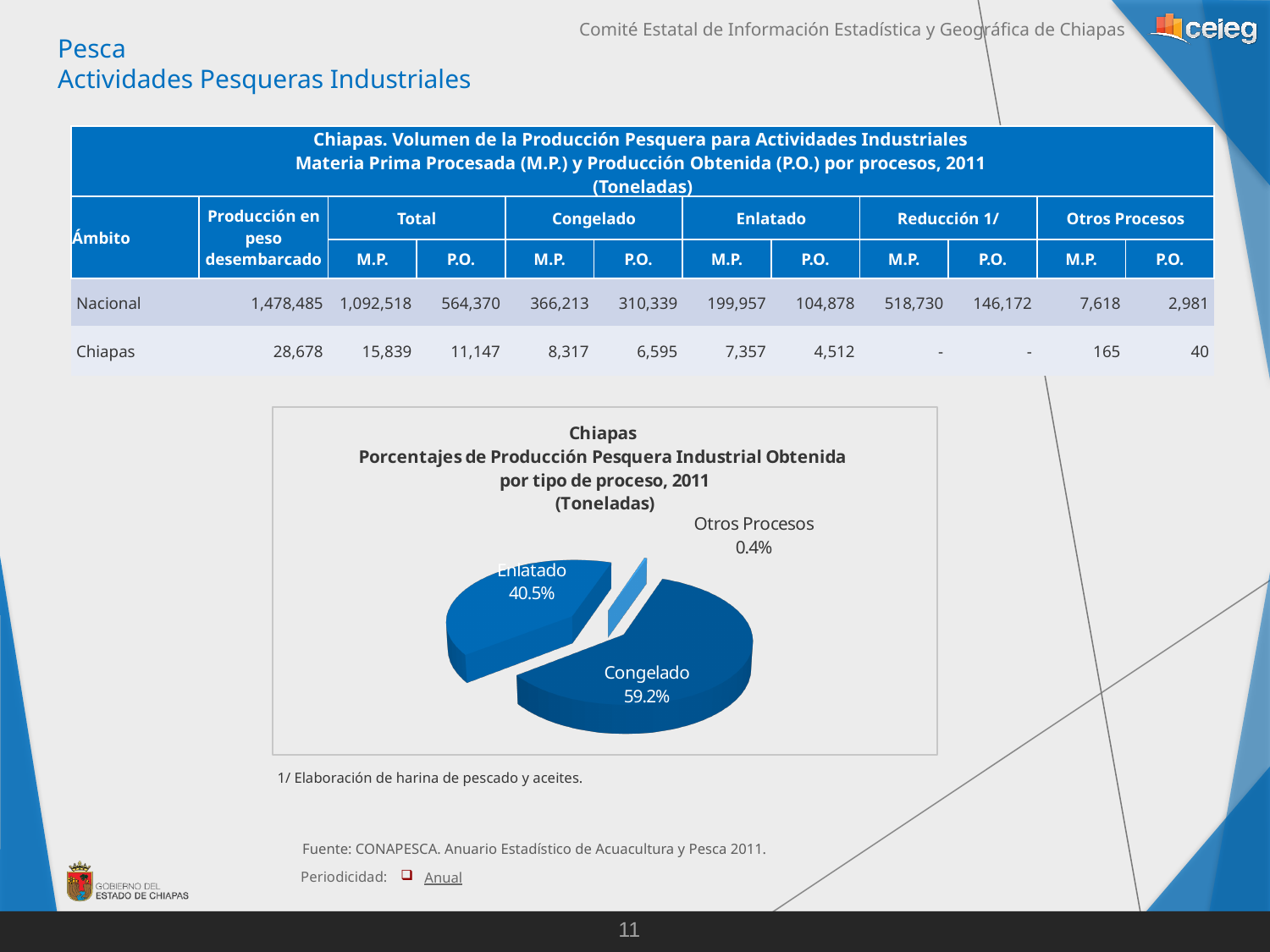
Which slice is larger, Enlatado or Otros Procesos? Enlatado What share of the pie does Otros Procesos represent? 0.4% How many slices does the pie chart have? 3 What kind of chart is shown on the slide? Pie chart What year does the pie chart title refer to? 2011 Which process type has the largest slice of the pie? Congelado Which process type has the smallest slice of the pie? Otros Procesos What share of the pie does Congelado represent? 59.2% Is the share for Congelado greater or less than 50%? greater What unit is given in parentheses in the pie chart title? Toneladas What share of the pie does Enlatado represent? 40.5% What is the difference in percentage points between the Congelado and Enlatado slices? 18.7